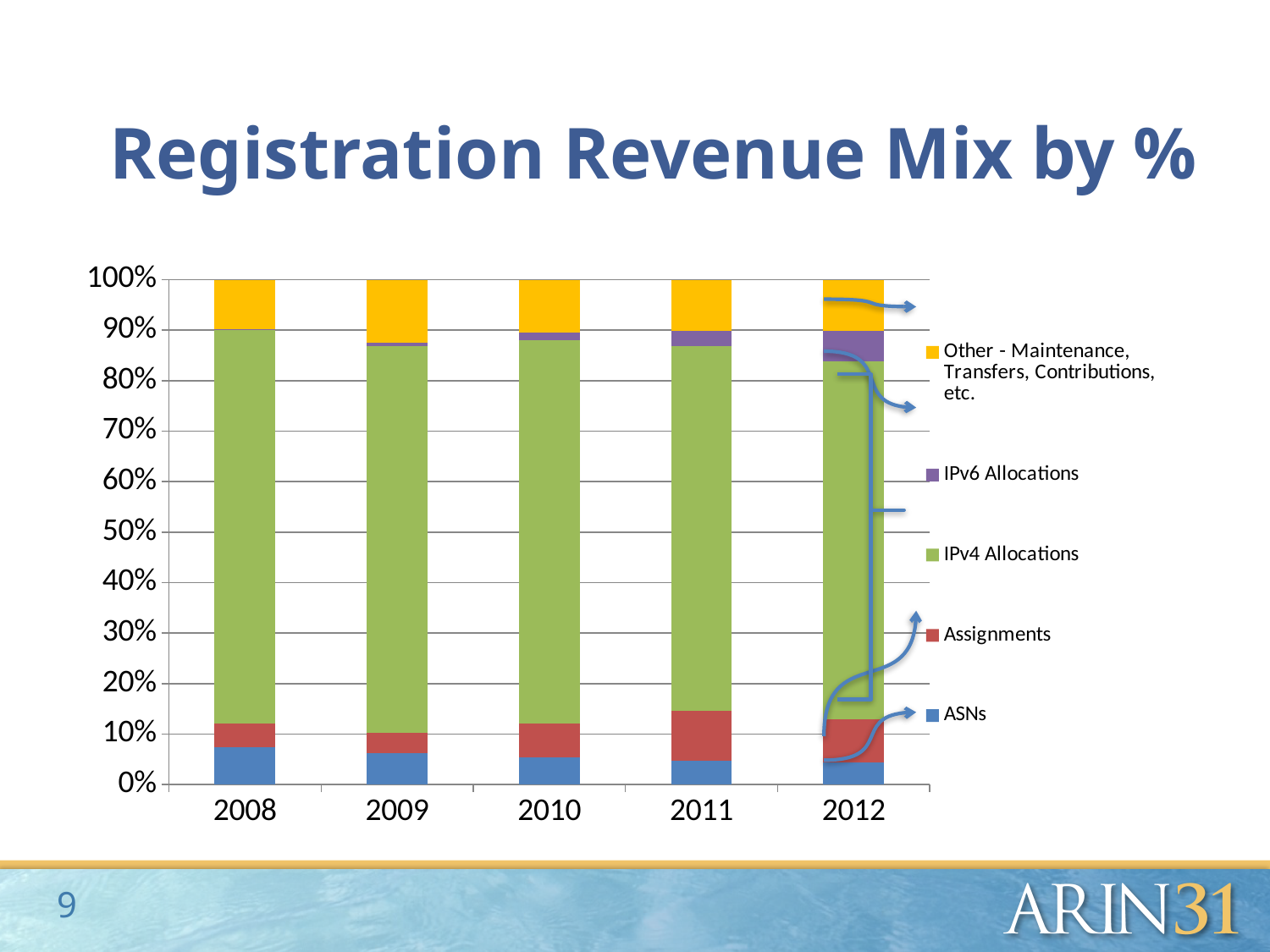
What is the title of the chart? Registration Revenue Mix by % Is the IPv4 Allocations share of revenue in 2012 greater or less than 60%? greater Is the ASNs share of revenue larger in 2008 or in 2012? 2008 What type of chart is shown on the slide? Stacked bar chart Which series is shown in green in the chart? IPv4 Allocations How many series does the chart's legend list? 5 Which year has the largest IPv6 Allocations share of revenue? 2012 Does the IPv6 Allocations share of revenue rise or fall from 2009 to 2012? rise Is the ASNs share of revenue in 2008 greater or less than 10%? less Which year has the largest ASNs share of revenue? 2008 Is the IPv6 Allocations share of revenue in 2012 greater or less than 10%? less How many years are shown along the x axis of the chart? 5